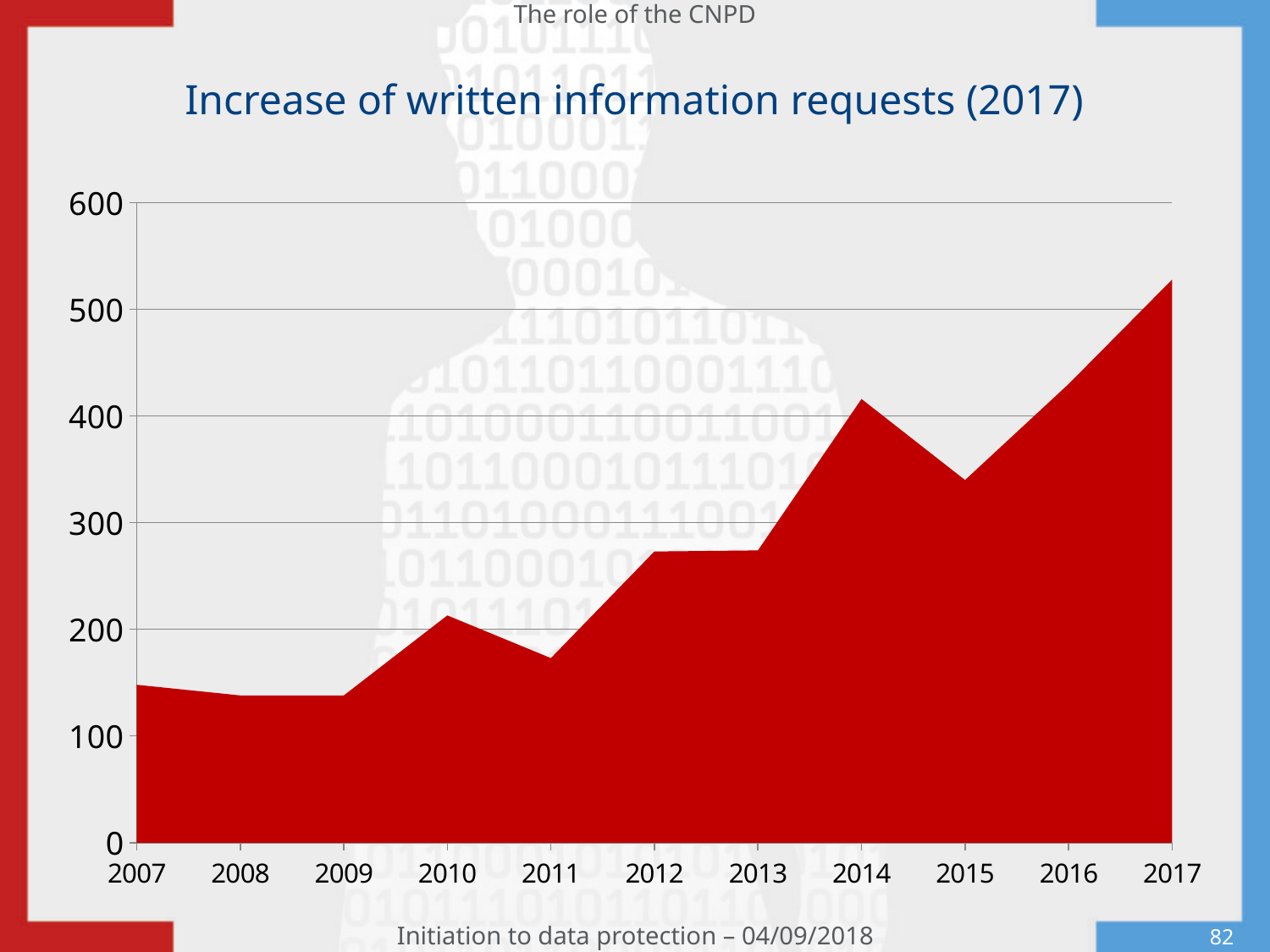
What type of chart is shown on the slide? Area chart How many years are plotted along the x axis? 11 Is the value for 2017 greater or less than 500? greater Is the value for 2012 greater or less than 300? less Is the value for 2014 greater or less than 400? greater What is the title of the chart? Increase of written information requests (2017) Which is larger, the value for 2014 or the value for 2015? 2014 Overall, do the values rise or fall from 2007 to 2017? rise Which year has the highest value? 2017